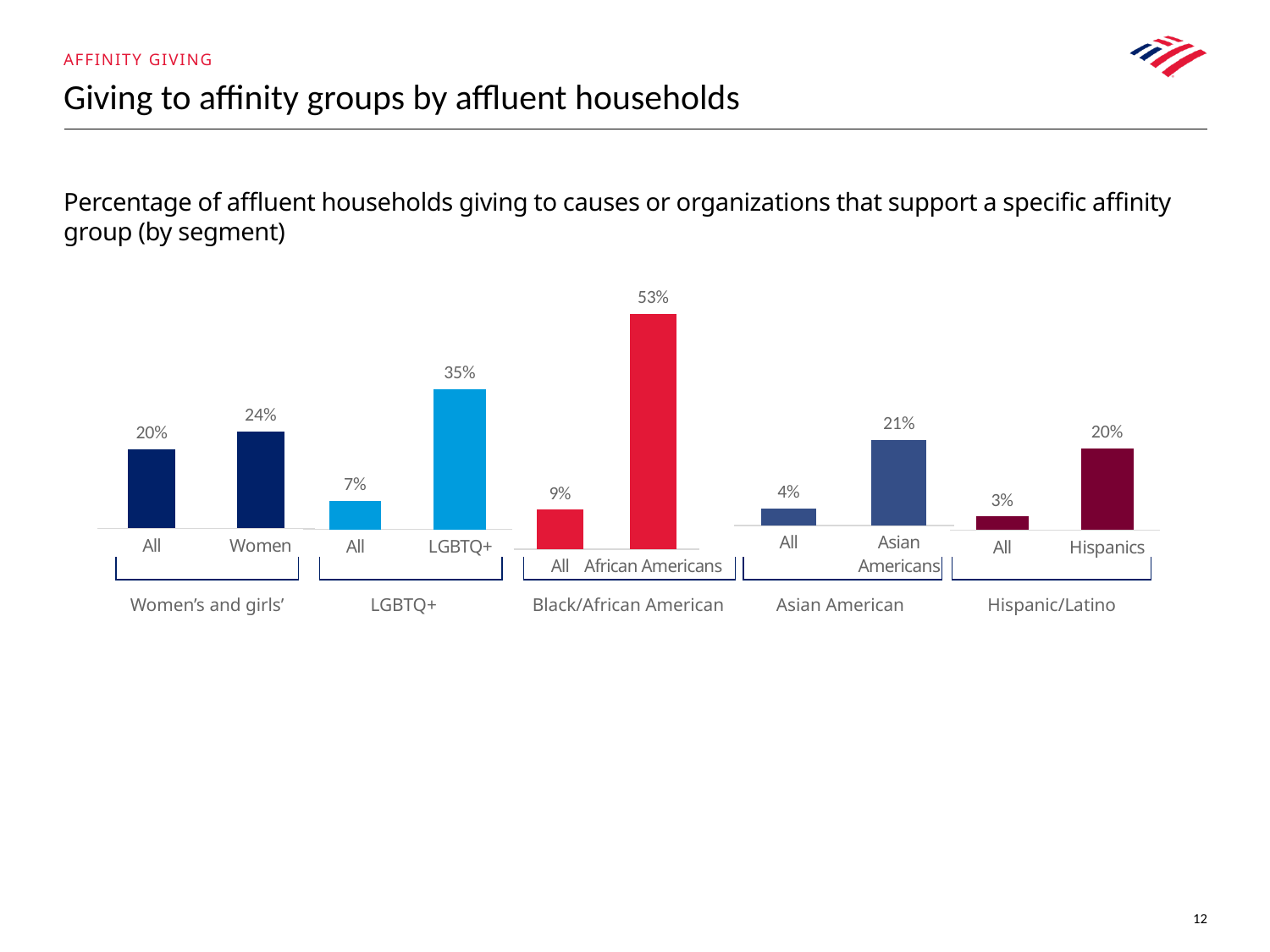
In the LGBTQ+ chart, what is the difference between the LGBTQ+ value and the All value? 28% In the Black/African American chart, what is the value for African Americans? 53% What type of chart is used on this slide? Bar chart In the Hispanic/Latino chart, what is the value for Hispanics? 20% In the Asian American chart, which is larger, the value for Asian Americans or the value for All? Asian Americans In the Asian American chart, what is the value for All households? 4% In the LGBTQ+ chart, what is the value for LGBTQ+ households? 35% Across all five charts, which bar has the lowest value? All (Hispanic/Latino chart), 3% Across all five charts, which segment has the highest percentage giving to its affinity group? African Americans In the Women's and girls' chart, what is the value for Women? 24% In the Black/African American chart, what is the difference between the African Americans value and the All value? 44% In the Women's and girls' chart, what percentage of all affluent households give to causes supporting women and girls? 20%